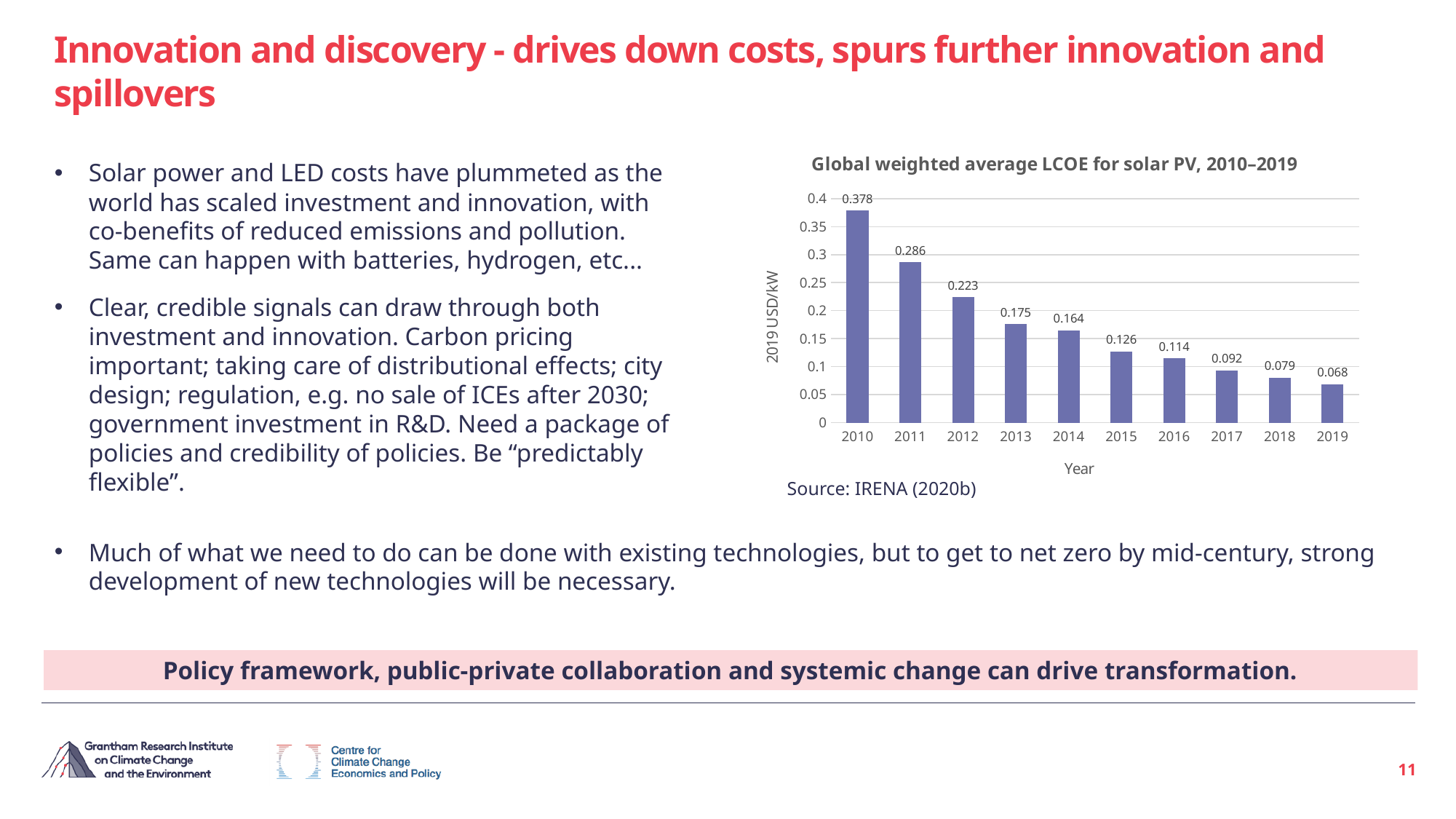
What is the difference between the 2012 and 2013 values? 0.048 What is the value shown for 2015? 0.126 Do the values rise or fall from 2010 to 2019? fall Which year has the lowest LCOE value? 2019 Which is larger, the value for 2014 or the value for 2016? 2014 What is the value shown for 2019? 0.068 What is the global weighted average LCOE for solar PV in 2010? 0.378 What is the difference between the 2010 and 2019 values? 0.310 What kind of chart is shown on the slide? bar chart Which year has the highest LCOE value? 2010 How many years are shown on the x axis? 10 Is the value for 2017 greater or less than 0.1? less